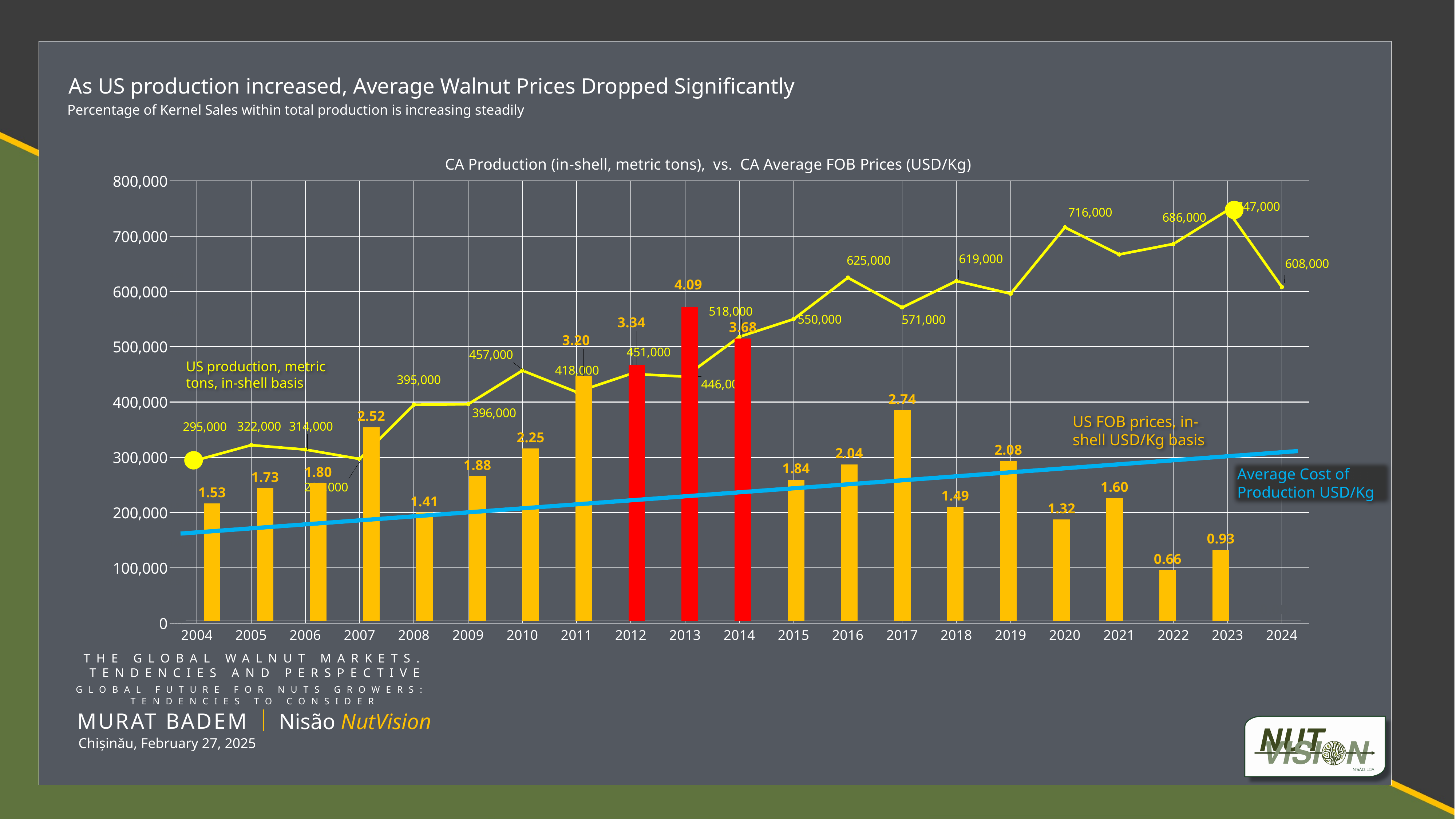
What is the US production value labelled for 2024? 608,000 Does the US production line generally rise or fall from 2004 to 2020? rise What kind of chart is shown on the slide? A combined bar and line chart What is the US production value labelled for 2020? 716,000 Which year has the highest CA average FOB price bar? 2013 Is the US production value for 2019 greater or less than 500,000? greater Which year has the lowest CA average FOB price bar? 2022 Which years' FOB price bars are coloured red instead of orange? 2012, 2013 and 2014 Which year has the higher FOB price, 2011 or 2017? 2011 What is the difference between the FOB price in 2013 and the FOB price in 2022? 3.43 What is the CA average FOB price shown for 2013? 4.09 How many years are shown on the x axis? 21